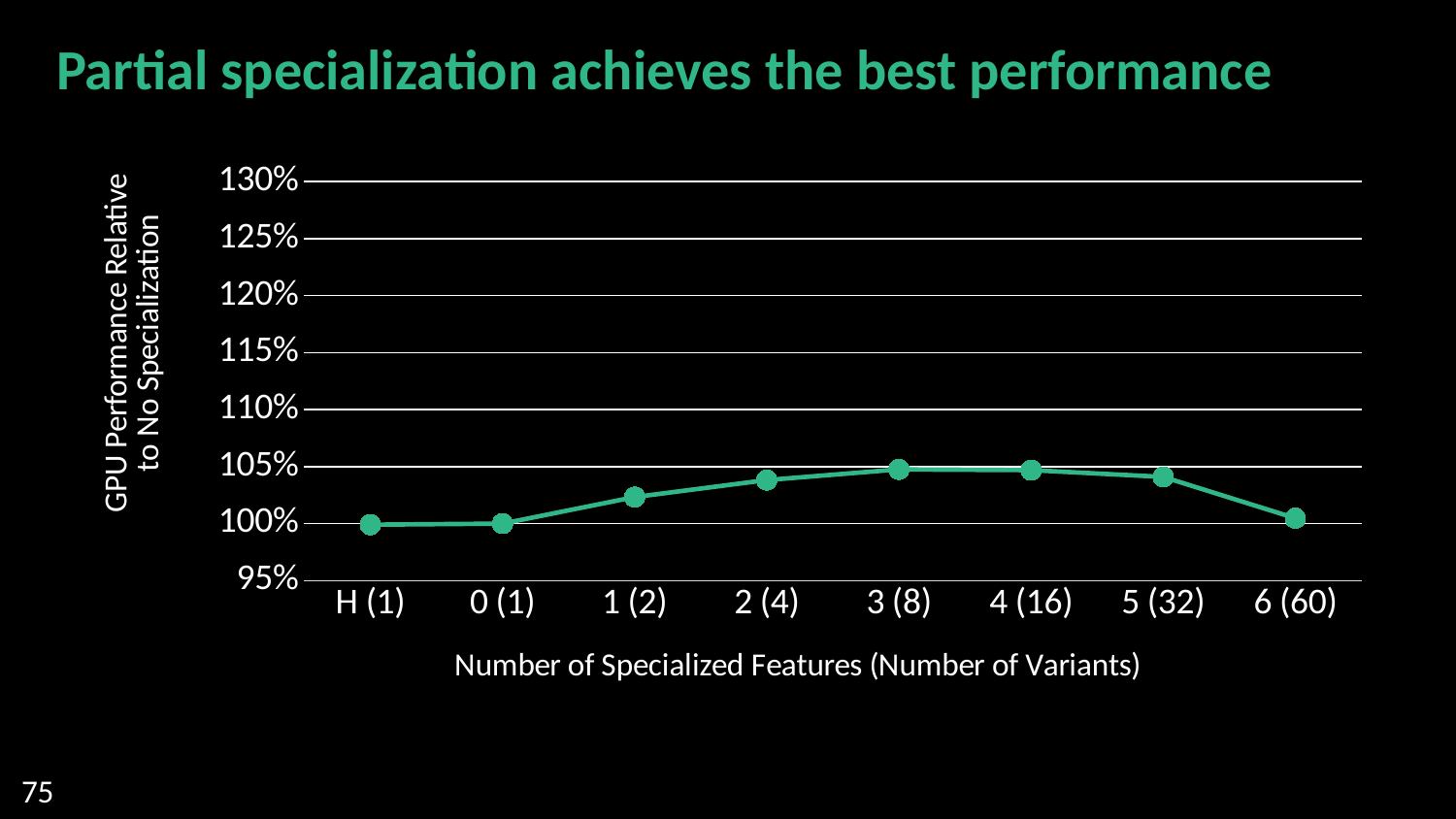
How many data points are plotted on the chart? 8 Is the value for 6 (60) greater or less than 105%? less Which has the higher value, 1 (2) or 2 (4)? 2 (4) Which has the higher value, 0 (1) or 3 (8)? 3 (8) Is the value for 2 (4) greater or less than 105%? less Is the value for 1 (2) greater or less than 100%? greater How does the line behave from left to right across the x axis? rises then falls What is the title of the slide? Partial specialization achieves the best performance Which has the higher value, 5 (32) or 6 (60)? 5 (32) What is the label of the x axis? Number of Specialized Features (Number of Variants) What kind of chart is shown on the slide? line chart